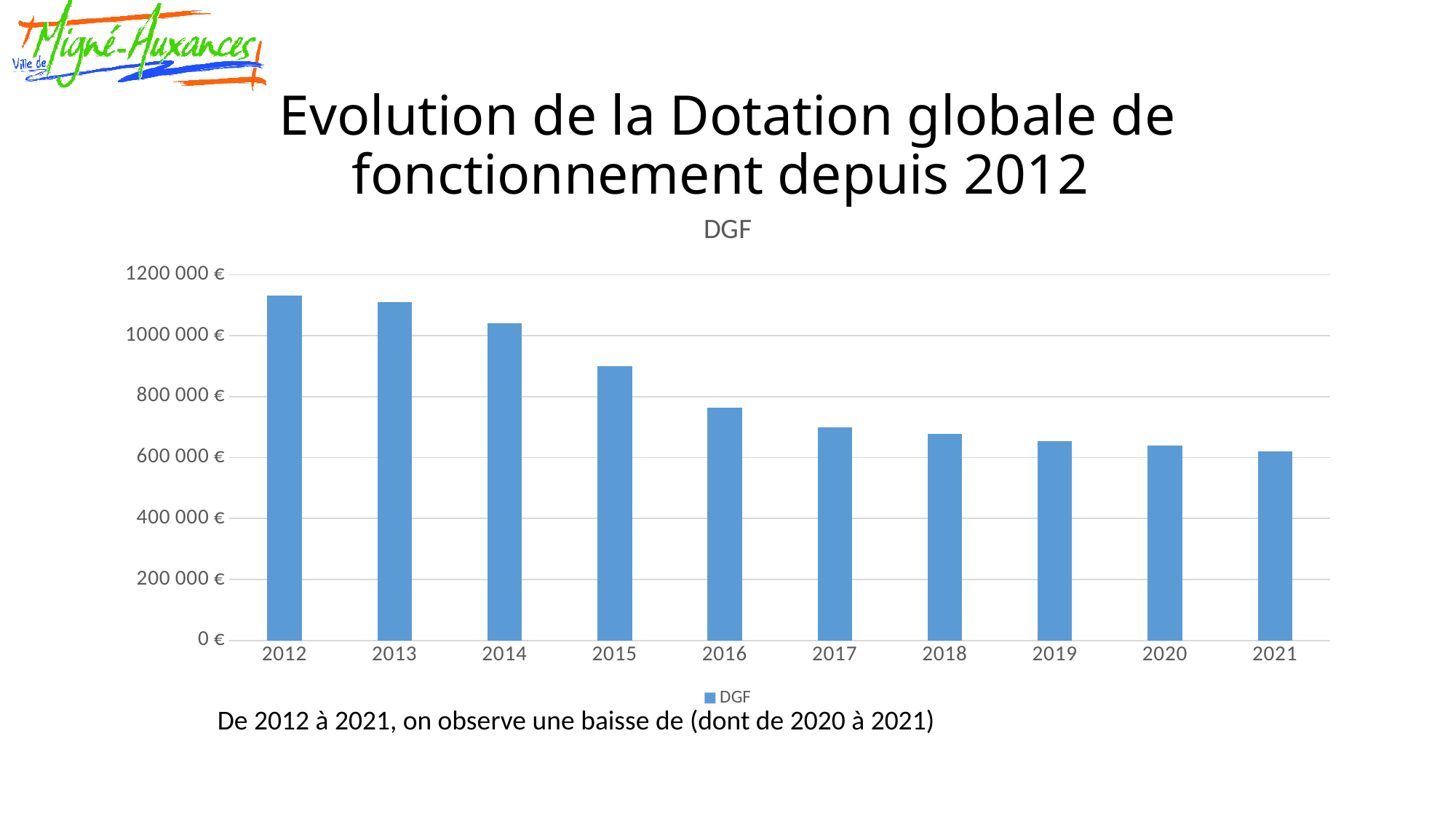
Is the DGF value for 2016 greater or less than 800 000 €? less What is the name of the series shown in the legend? DGF Which is larger, the DGF value for 2014 or for 2017? 2014 Is the DGF value for 2021 greater or less than 600 000 €? greater How many years are plotted on the x axis of the chart? 10 What kind of chart is shown on the slide? Bar chart Is the DGF value for 2015 greater or less than 1000 000 €? less Do the DGF values rise or fall from 2012 to 2021? Fall How many series does the chart legend list? 1 What is the title shown above the chart? DGF Which year has the highest DGF value? 2012